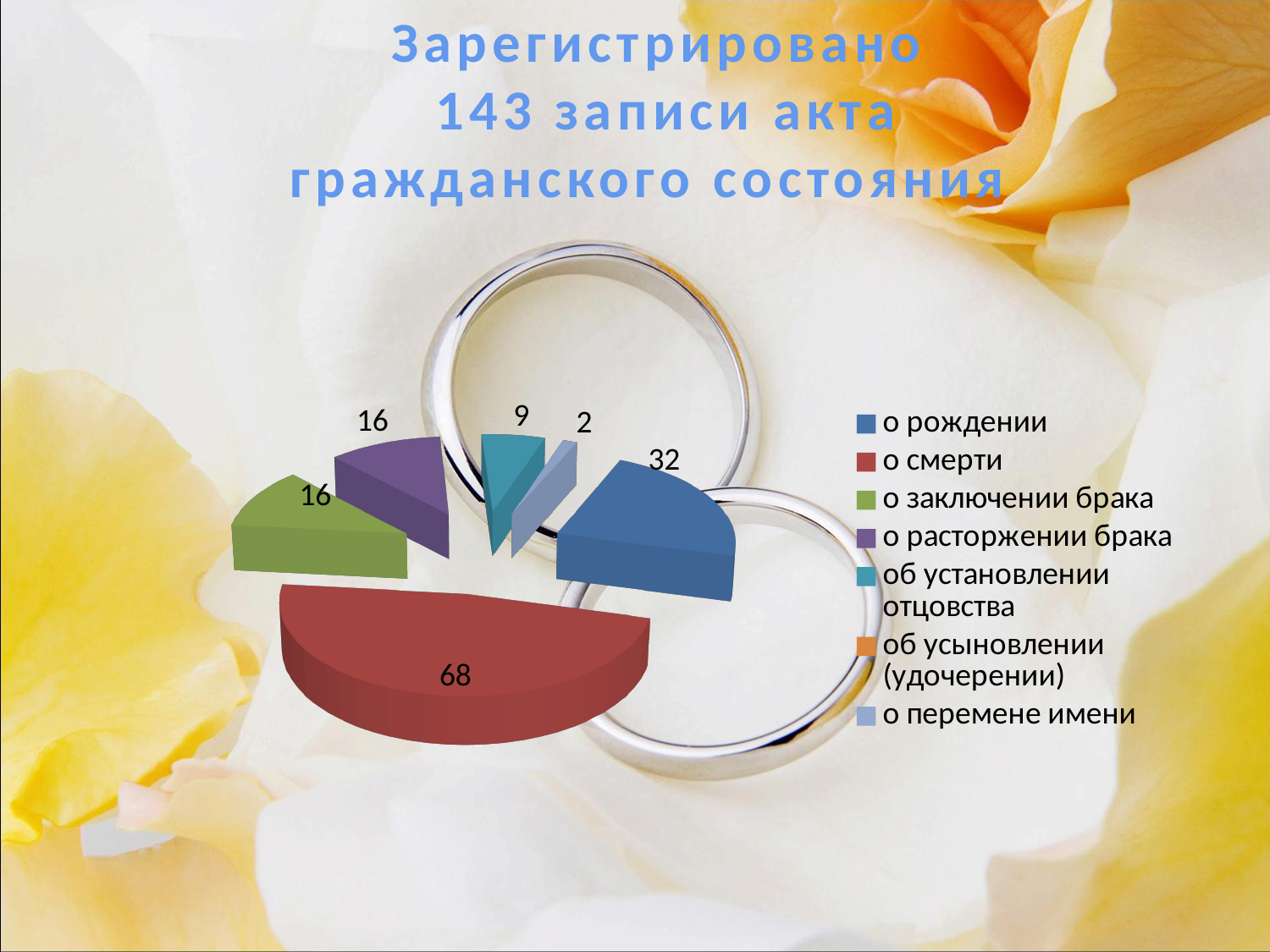
Which is larger, the value for "о рождении" or the value for "о расторжении брака"? о рождении What is the difference between the values for "о смерти" and "о рождении"? 36 What colour is the slice for "о смерти" in the pie chart? Red What is the value for "о смерти" in the pie chart? 68 Which category has the largest slice in the pie chart? о смерти What is the value for "о перемене имени" in the pie chart? 2 How many slices with data labels are shown in the pie chart? 6 What is the value for "об установлении отцовства" in the pie chart? 9 What is the value for "о заключении брака" in the pie chart? 16 What is the value for "о рождении" in the pie chart? 32 How many entries does the legend of the pie chart list? 7 What type of chart is shown on the slide? Pie chart